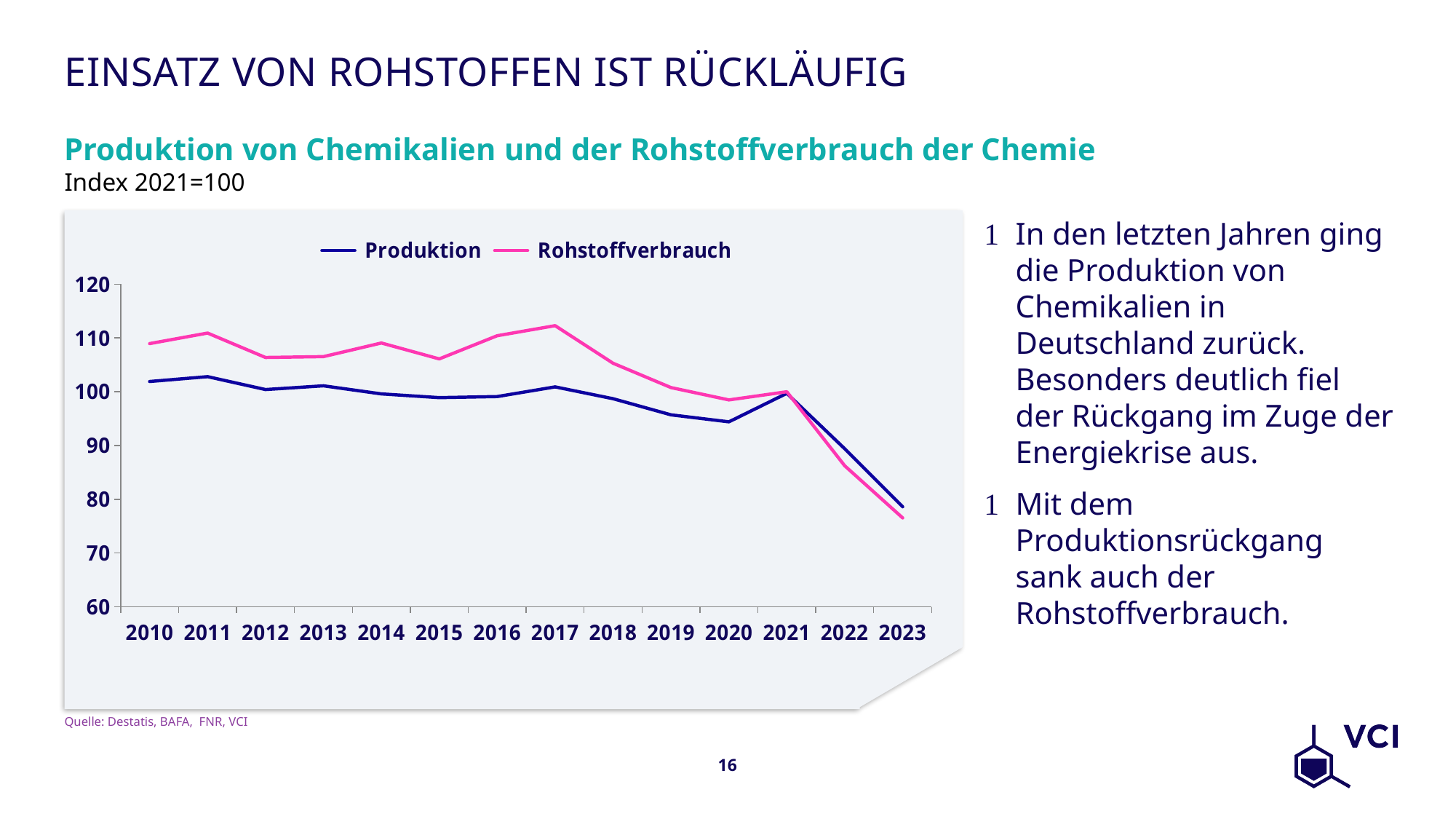
What kind of chart is shown on the slide? Line chart In which year is the Produktion series at its lowest? 2023 Which colour is used for the Rohstoffverbrauch line in the chart? Pink Is the value for Rohstoffverbrauch in 2022 greater or less than 90? less How many series does the chart legend list? 2 Is the value for Produktion in 2020 greater or less than 100? less How many years are shown on the x axis of the chart? 14 Is the value for Produktion in 2023 greater or less than 80? less Do the values of Rohstoffverbrauch rise or fall from 2021 to 2023? Fall In 2017, which series has the higher value, Produktion or Rohstoffverbrauch? Rohstoffverbrauch